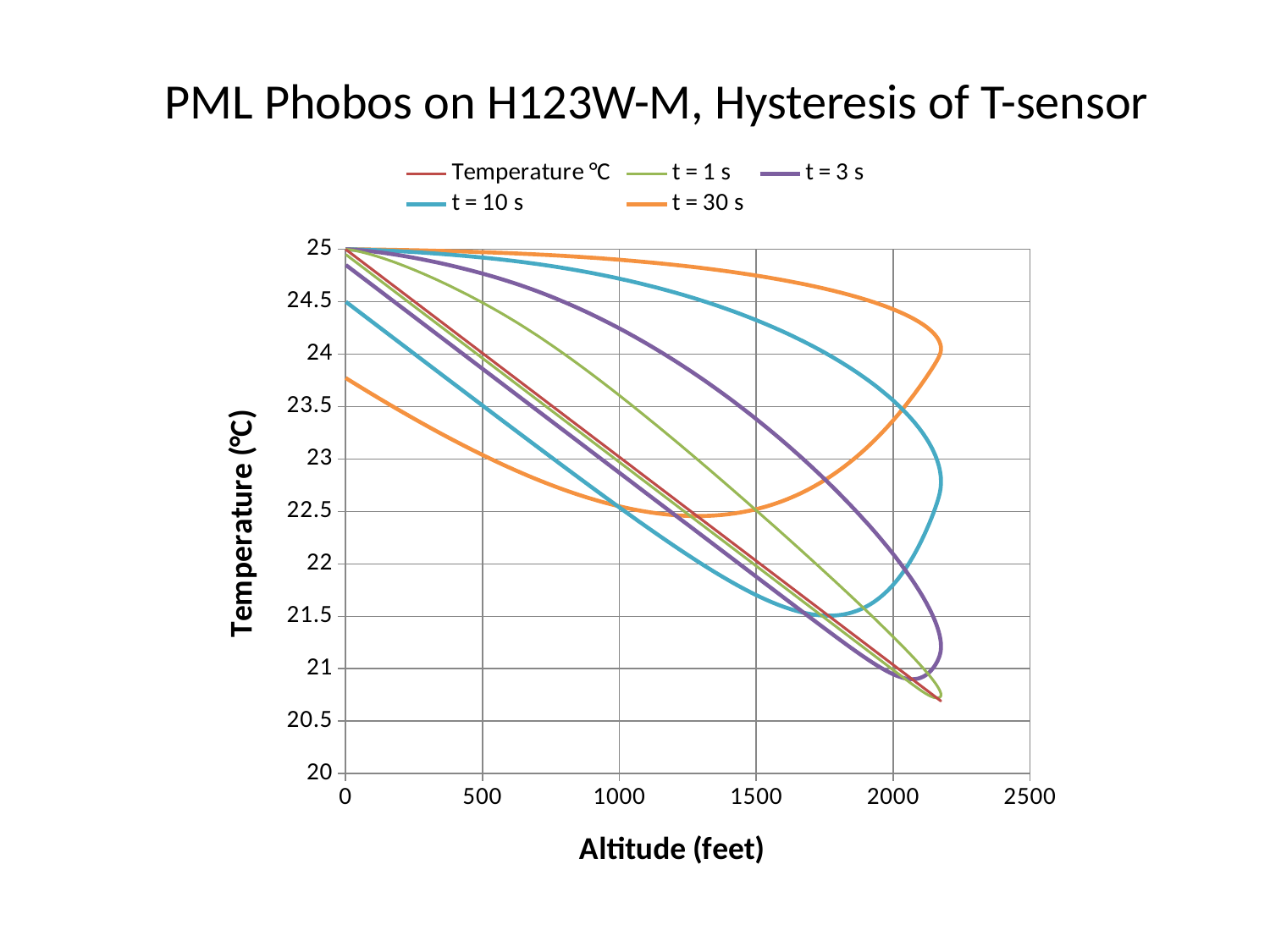
Is the value of the upper branch of the t = 30 s series at 2000 feet greater or less than 24? greater Is the lowest temperature reached by the Temperature °C series greater or less than 20.5? greater At 2000 feet, which series has the higher upper-branch temperature, t = 30 s or t = 10 s? t = 30 s What is the label of the horizontal axis? Altitude (feet) Does the Temperature °C series rise or fall as altitude increases? fall Is the value of the lower branch of the t = 10 s series at 1500 feet greater or less than 22? less What is the title of the chart? PML Phobos on H123W-M, Hysteresis of T-sensor How many series does the legend list? 5 What kind of chart is shown on the slide? line chart